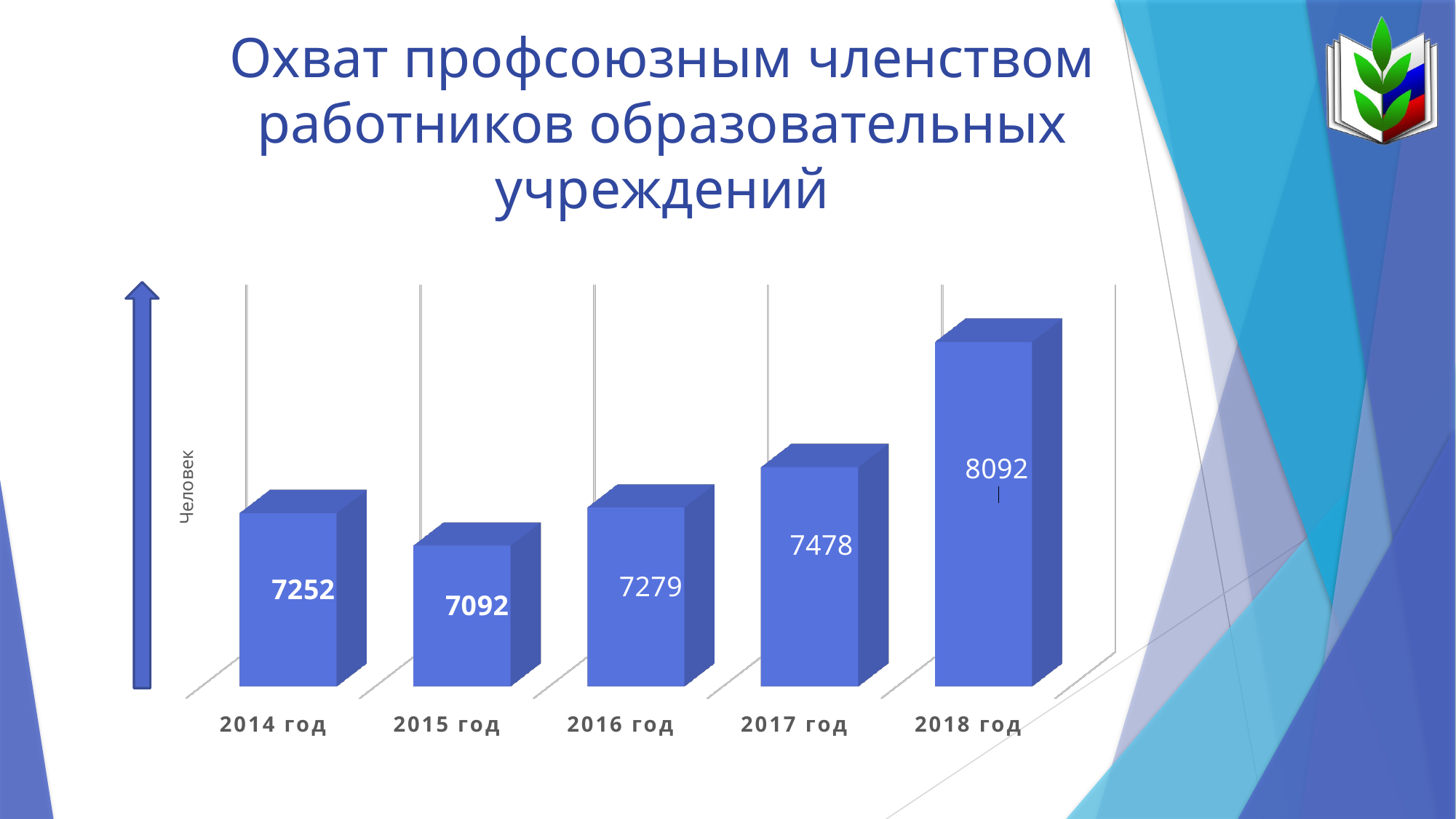
What is the value for 2018 год? 8092 What is the difference between the values for 2018 год and 2017 год? 614 Which year has the lowest value? 2015 год What kind of chart is shown on the slide? bar chart How many years are shown on the chart? 5 What is the value for 2015 год? 7092 Which is larger, the value for 2014 год or the value for 2015 год? 2014 год What is the value for 2016 год? 7279 What is the value for 2017 год? 7478 Which year has the highest value? 2018 год What is the value for 2014 год? 7252 What is the label on the vertical axis of the chart? Человек